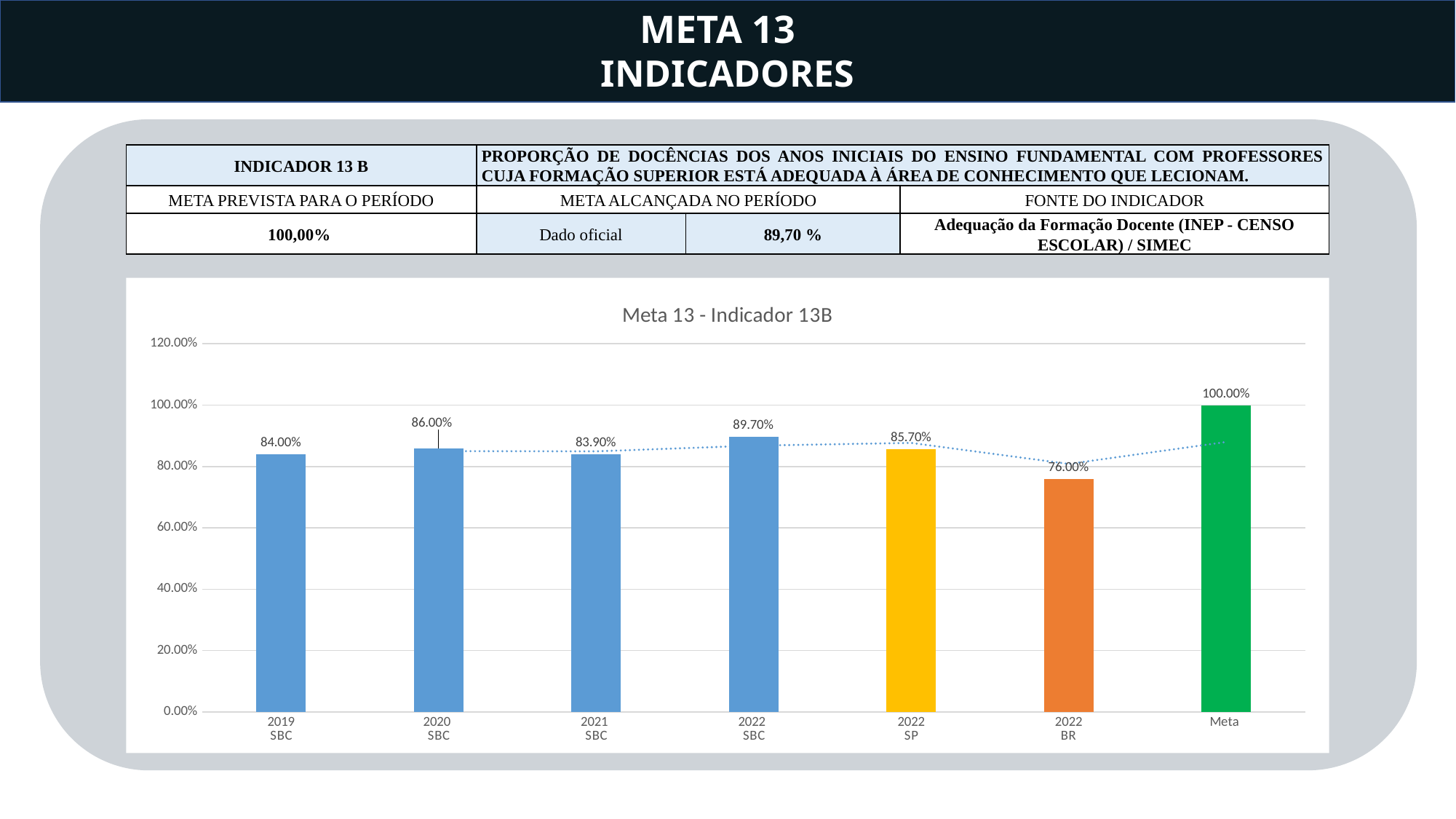
What is the value for 2022 SBC in the chart? 89.70% Which category has the highest value in the chart? Meta What is the difference between the 2022 SBC value and the 2022 BR value? 13.70% What is the value for 2022 BR in the chart? 76.00% What is the value for 2019 SBC in the chart? 84.00% Is the value for 2022 BR greater or less than 80.00%? less Which category has the lowest value in the chart? 2022 BR What is the difference between the Meta value and the 2022 SBC value? 10.30% What is the value for 2022 SP in the chart? 85.70% Which is larger, the value for 2020 SBC or the value for 2021 SBC? 2020 SBC What type of chart is shown on the slide? Bar chart How many bars are shown in the chart? 7